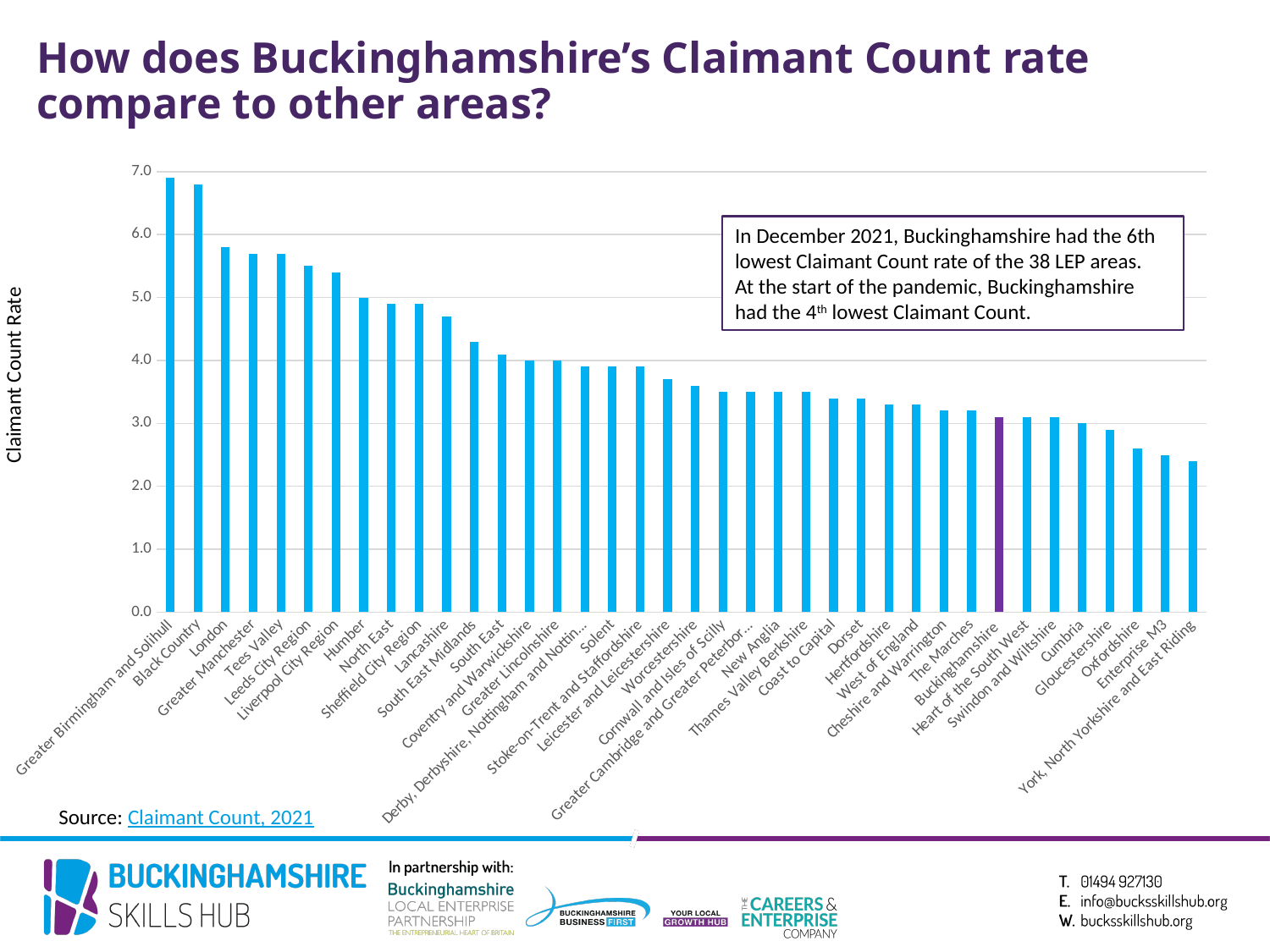
Which has the higher Claimant Count rate, London or Cumbria? London Which bar on the chart is coloured purple rather than blue? Buckinghamshire How many LEP areas are plotted on the chart? 38 Is the Claimant Count rate for Oxfordshire greater or less than 3.0? less Is the Claimant Count rate for Lancashire greater or less than 4.0? greater Do the Claimant Count rates rise or fall moving from left to right along the x axis? fall Which has the higher Claimant Count rate, Dorset or Black Country? Black Country What kind of chart is shown on the slide? bar chart Is the Claimant Count rate for London greater or less than 5.0? greater